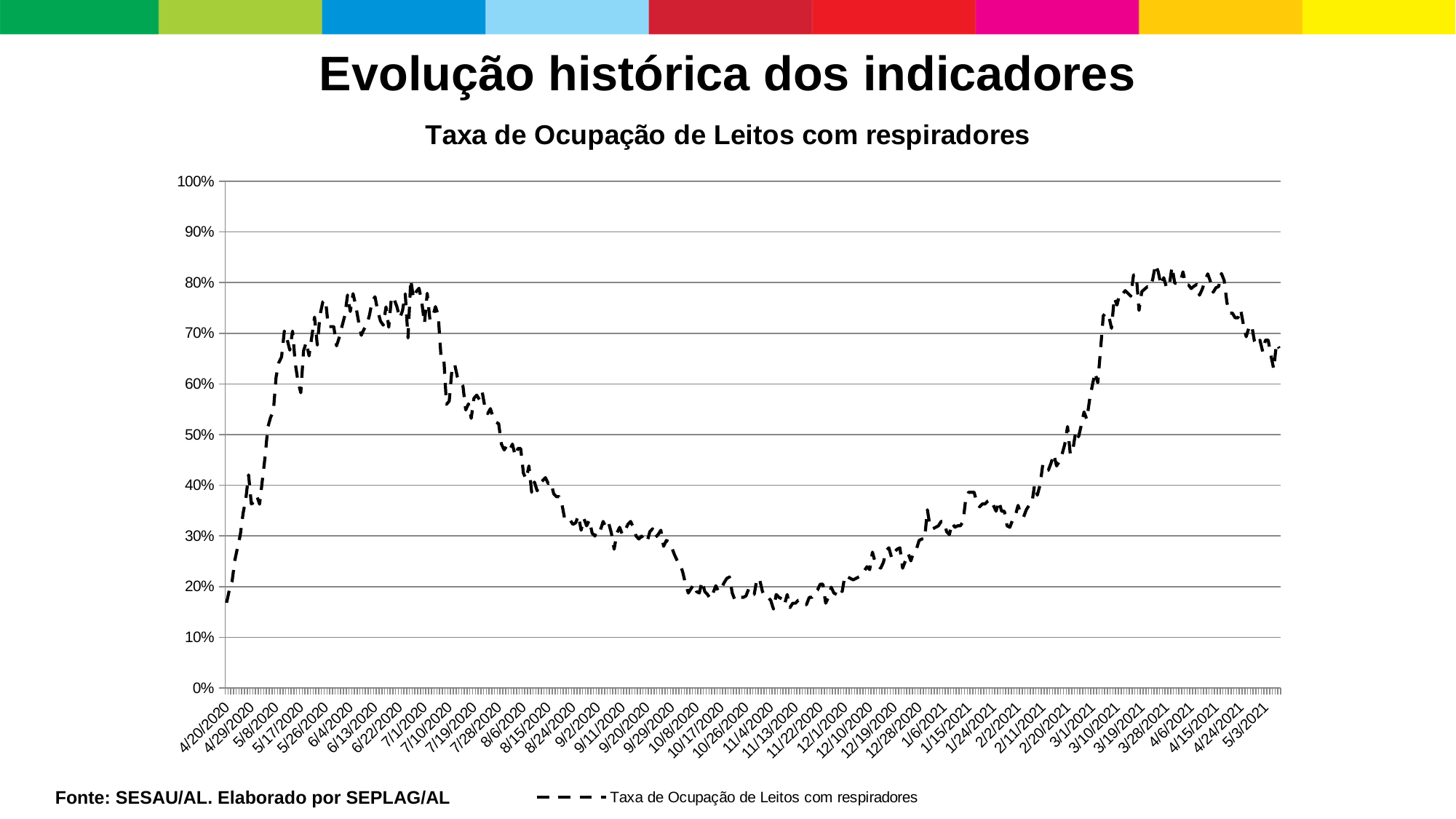
Do the values rise or fall between 2/11/2021 and 3/19/2021? rise What kind of chart is shown on the slide? line chart What is the title of the chart? Taxa de Ocupação de Leitos com respiradores Is the value for 4/6/2021 greater or less than 70%? greater How many series does the legend list? 1 Is the value for 9/11/2020 greater or less than 40%? less Is the value for 11/13/2020 greater or less than 20%? less What is the highest value shown on the vertical axis? 100% Do the values rise or fall between 7/10/2020 and 10/8/2020? fall Which is larger, the value for 7/1/2020 or the value for 11/13/2020? 7/1/2020